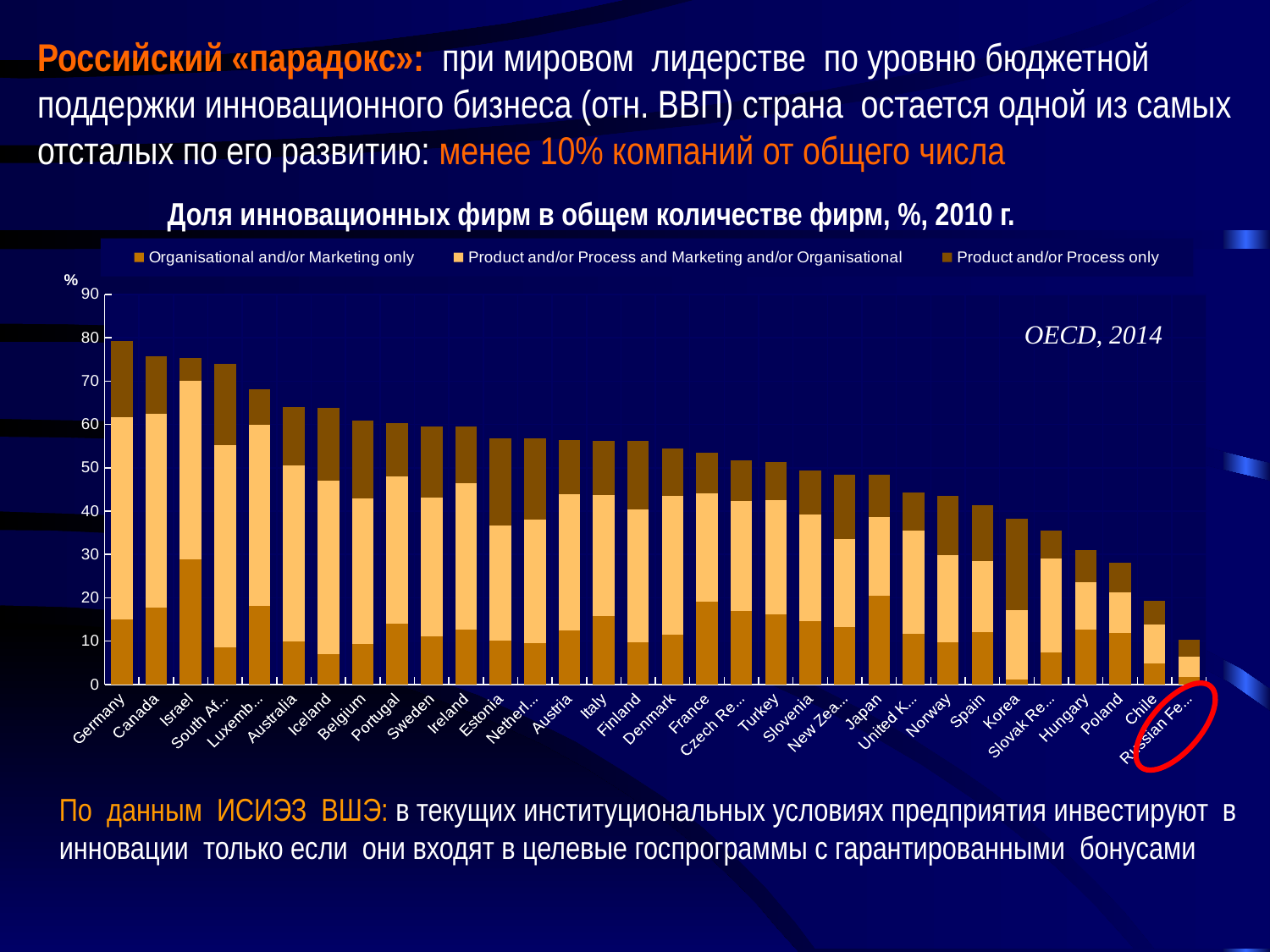
What source is cited on the chart? OECD, 2014 What kind of chart is shown on the slide? stacked bar chart Do the total bar heights rise or fall from left to right along the x axis? fall Is the total value for Russian Fe... greater or less than 20? less How many countries are shown on the x axis of the chart? 32 How many series does the legend list? 3 Is the total value for Japan greater or less than 40? greater Which country has the lowest total share of innovative firms? Russian Fe... Is the total value for Germany greater or less than 70? greater Which has a larger total share of innovative firms, Canada or Chile? Canada Which country has the highest total share of innovative firms? Germany